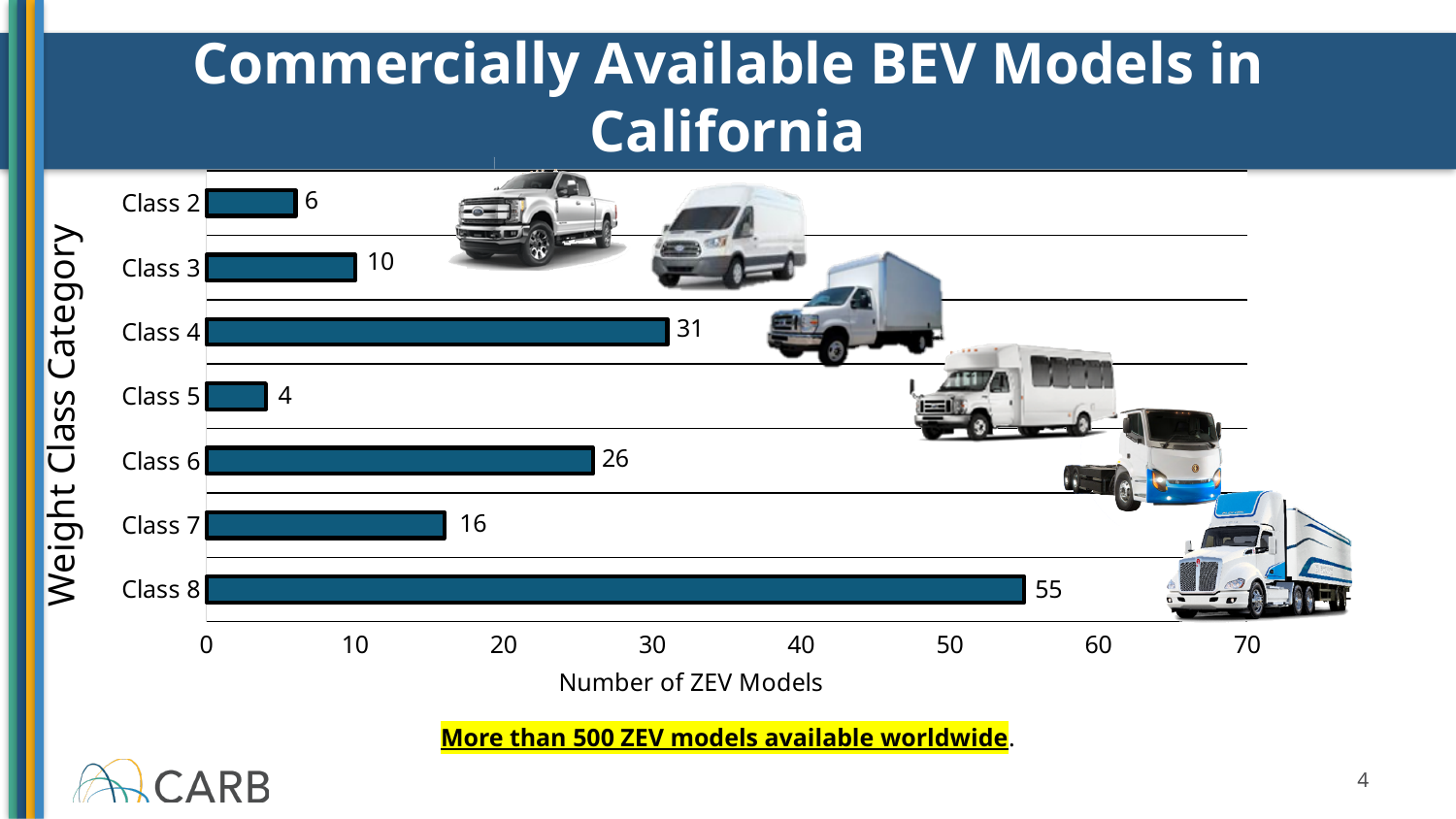
Which weight class category has the highest number of ZEV models? Class 8 What is the number of ZEV models for Class 8? 55 How many BEV models are available for Class 4? 31 Which weight class category has the lowest number of ZEV models? Class 5 Which has more BEV models, Class 3 or Class 7? Class 7 How many BEV models are shown for Class 5? 4 What is the label of the horizontal axis of the chart? Number of ZEV Models Is the value for Class 6 greater or less than 20? greater How many weight class categories are shown in the chart? 7 What is the difference between the number of models for Class 8 and Class 4? 24 What is the difference between the number of models for Class 6 and Class 7? 10 What kind of chart is shown on the slide? Bar chart